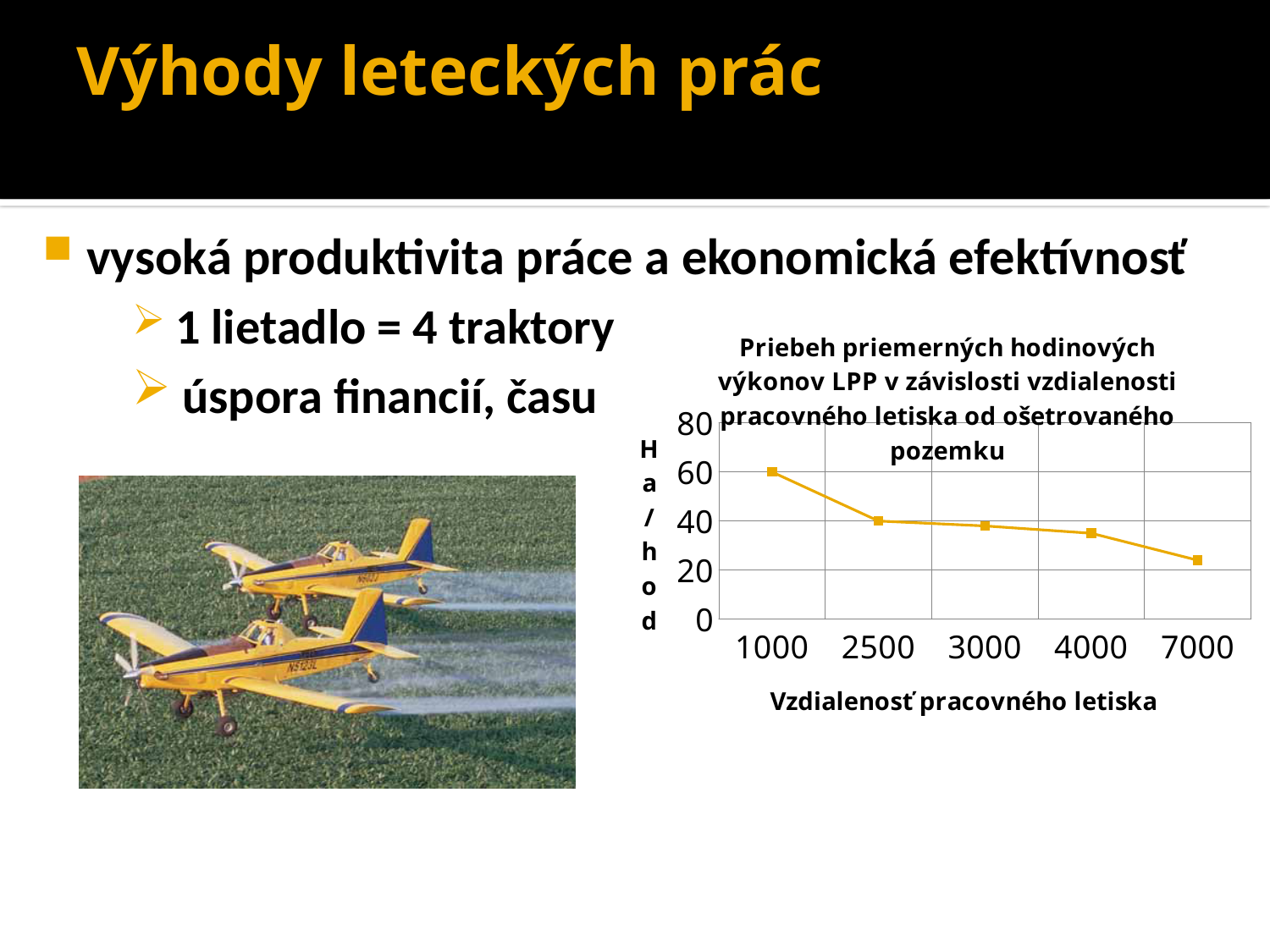
What is the title of the x axis? Vzdialenosť pracovného letiska Which distance category has the lowest value? 7000 Which is larger, the value at 1000 or the value at 7000? 1000 How many data points are plotted on the chart? 5 What unit label is shown on the y axis? Ha/hod What is the value (Ha/hod) at a distance of 1000? 60 Which distance category has the highest value? 1000 Do the values rise or fall as the distance increases along the x axis? fall What kind of chart is shown on the slide? line chart Is the value for 7000 greater or less than 20? greater What is the value (Ha/hod) at a distance of 2500? 40 Is the value for 4000 greater or less than 40? less